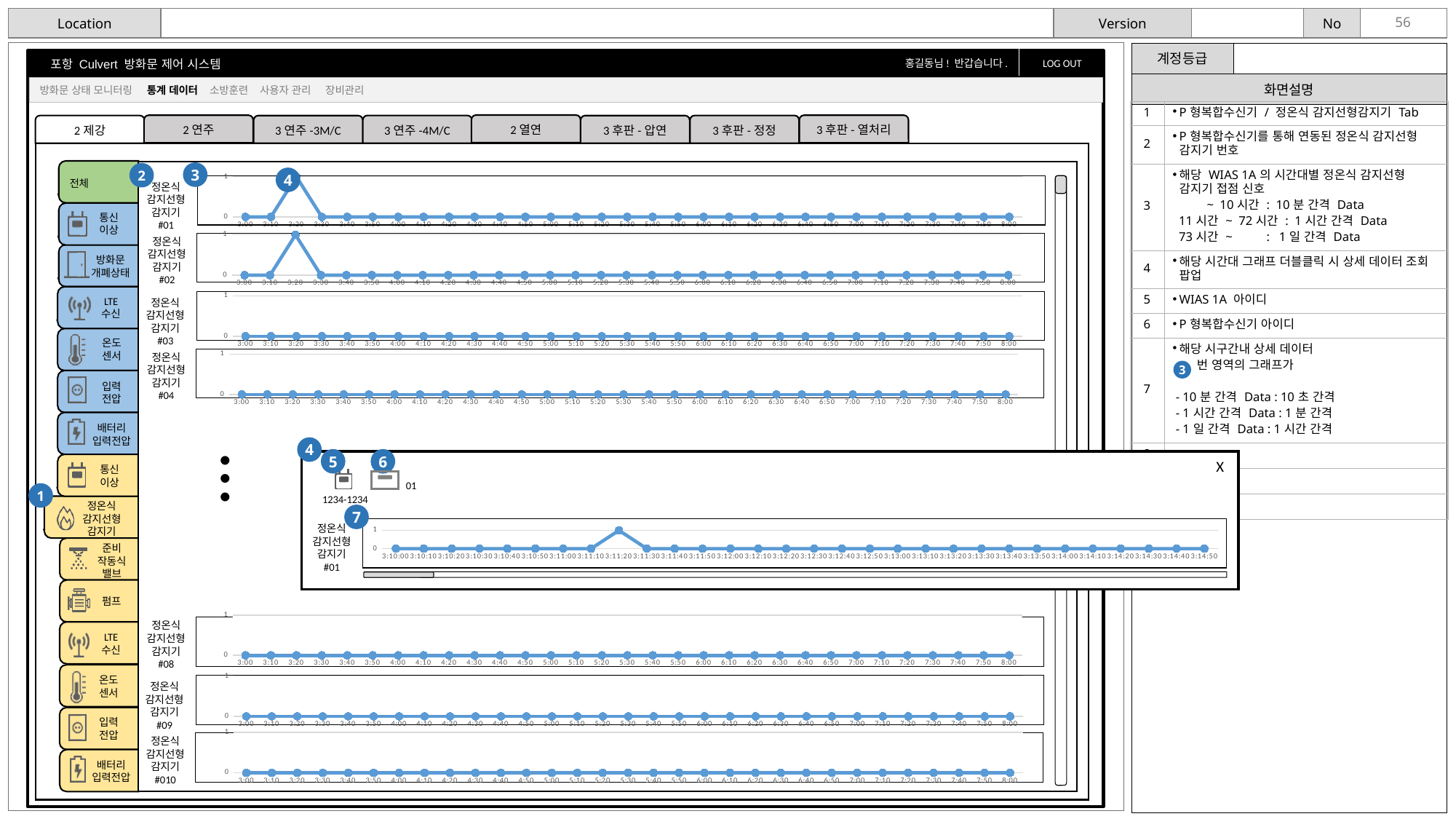
In the 정온식 감지선형 감지기 #02 chart, at which time is the value highest? 3:20 What kind of chart is used for 정온식 감지선형 감지기 #01 in the main panel? line chart In the 정온식 감지선형 감지기 #01 chart in the main panel, what is the value at 3:10? 0 In the 정온식 감지선형 감지기 #03 chart, what is the value at 5:00? 0 In the 정온식 감지선형 감지기 #04 chart, do the values rise, fall, or stay flat across the x axis? stay flat In the popup chart for 정온식 감지선형 감지기 #01, at which time does the value reach 1? 3:11:20 What is the first x-axis label on the 정온식 감지선형 감지기 #08 chart? 3:00 What is the highest y-axis tick shown on the 정온식 감지선형 감지기 #09 chart? 1 In the 정온식 감지선형 감지기 #01 chart in the main panel, what is the value at 3:20? 1 In the popup chart for 정온식 감지선형 감지기 #01, what is the value at 3:11:20? 1 In the 정온식 감지선형 감지기 #01 chart in the main panel, is the value at 3:20 larger or smaller than the value at 3:30? larger In the 정온식 감지선형 감지기 #02 chart, what is the difference between the value at 3:20 and the value at 3:10? 1